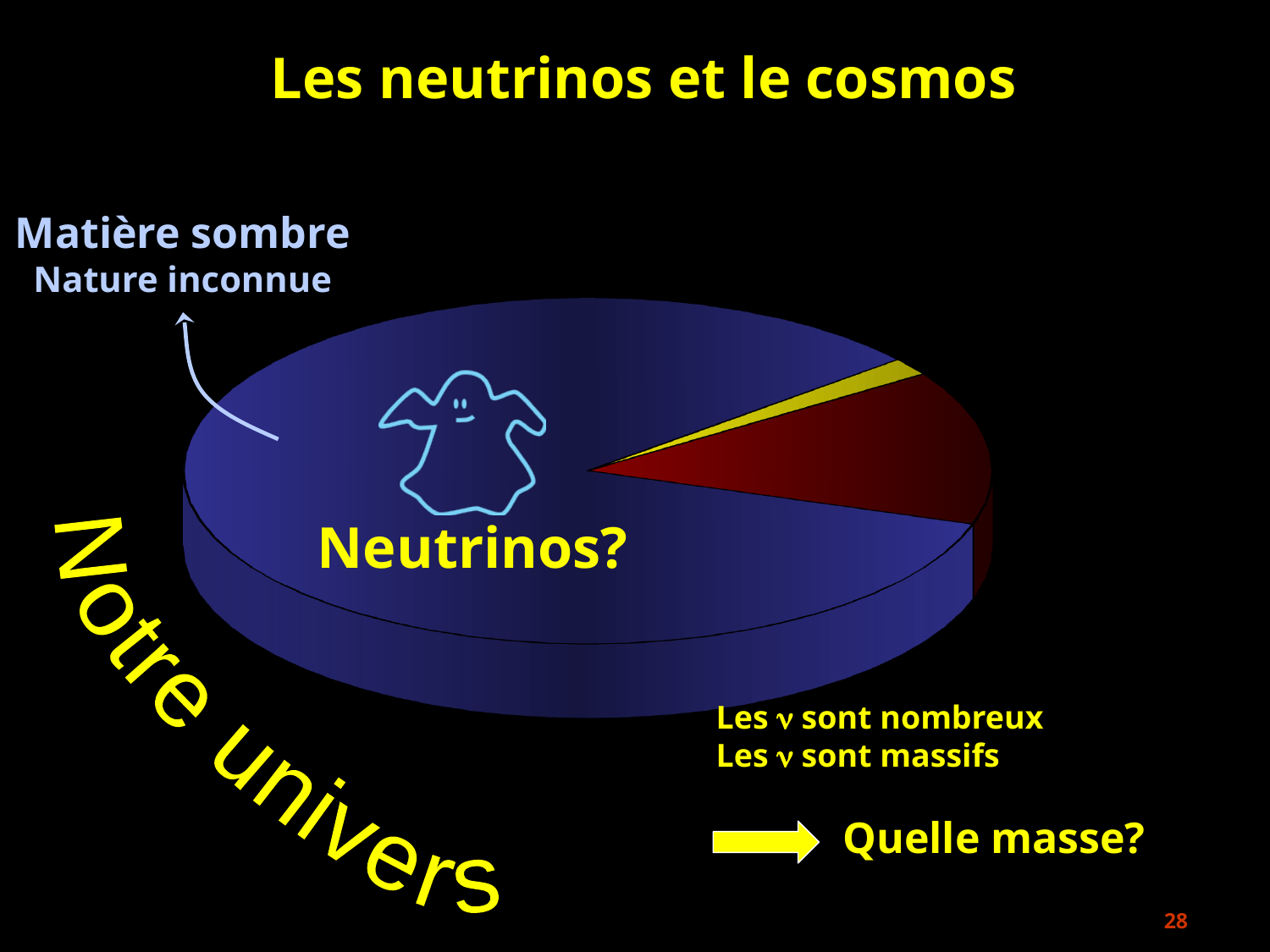
Which is larger in the pie chart, the blue slice (Matière sombre) or the red slice? the blue slice (Matière sombre) Which slice of the pie chart is the largest? Matière sombre (the blue slice) What is the title of the slide containing the pie chart? Les neutrinos et le cosmos How many slices does the pie chart have? 3 What colour is the slice labelled Matière sombre? blue Which slice of the pie chart is the smallest? the yellow slice Does the Matière sombre slice take up more or less than half of the pie? more Which is larger in the pie chart, the red slice or the yellow slice? the red slice What kind of chart is shown on the slide? pie chart